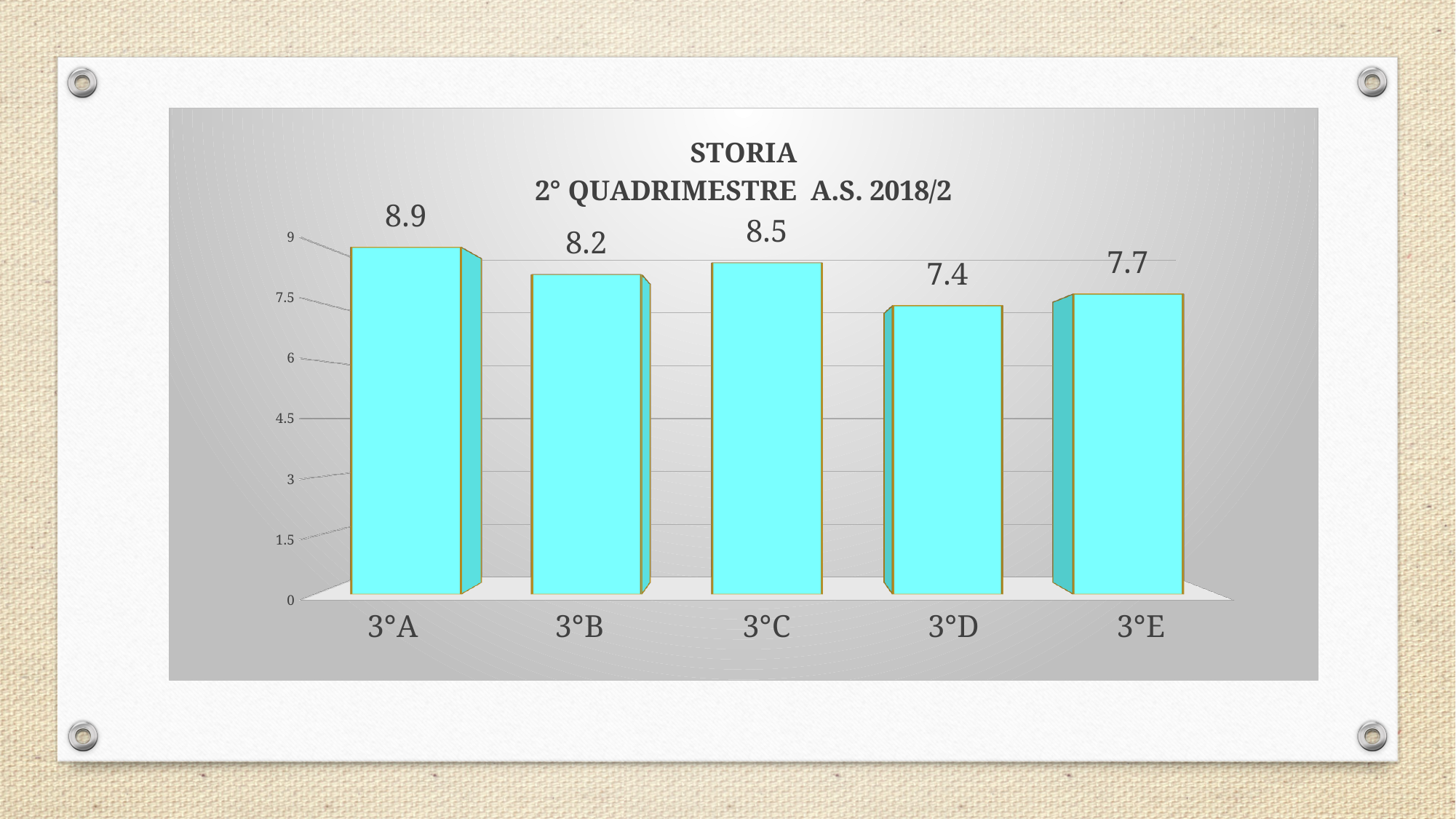
Which is larger, the value for 3°B or the value for 3°E? 3°B What is the difference between the values for 3°C and 3°B? 0.3 What kind of chart is shown? bar chart Which class has the highest value? 3°A What is the title of the chart? STORIA 2° QUADRIMESTRE A.S. 2018/2 How many classes are shown on the x axis? 5 What is the value for 3°E? 7.7 Is the value for 3°C greater or less than 7.5? greater What is the difference between the values for 3°A and 3°D? 1.5 Which class has the lowest value? 3°D What is the value for 3°D? 7.4 What is the value for 3°A? 8.9